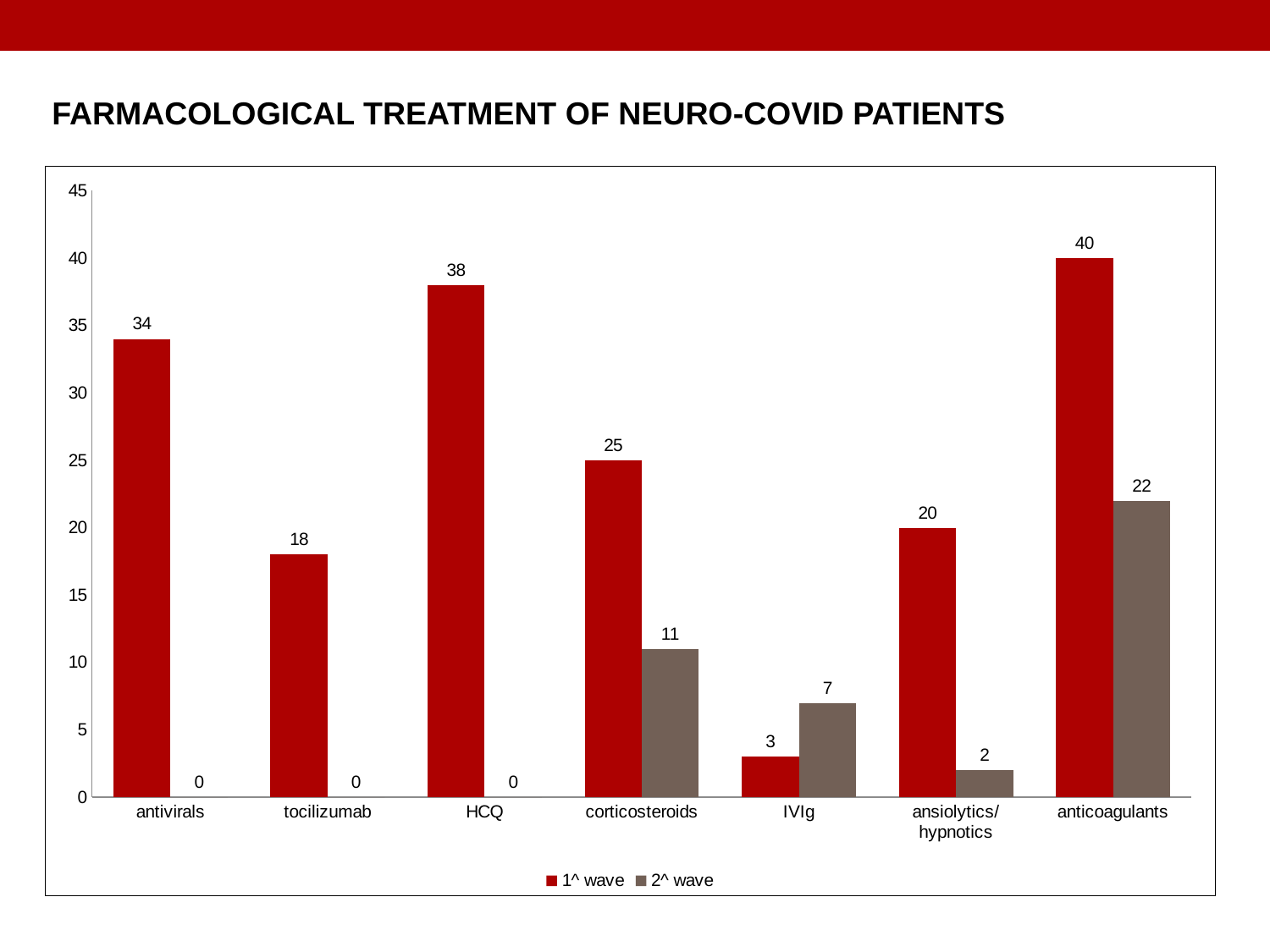
Which is larger for IVIg, the 1^ wave value or the 2^ wave value? 2^ wave How many treatment categories are shown on the x axis? 7 How many series does the legend list? 2 What kind of chart is shown on the slide? bar chart What is the 2^ wave value for antivirals? 0 What is the title of the slide? FARMACOLOGICAL TREATMENT OF NEURO-COVID PATIENTS Which category has the lowest 1^ wave value? IVIg Is the 1^ wave value for tocilizumab greater or less than 20? less What is the 2^ wave value for corticosteroids? 11 Which category has the highest 1^ wave value? anticoagulants What is the 1^ wave value for HCQ? 38 What is the difference between the 1^ wave and 2^ wave values for anticoagulants? 18